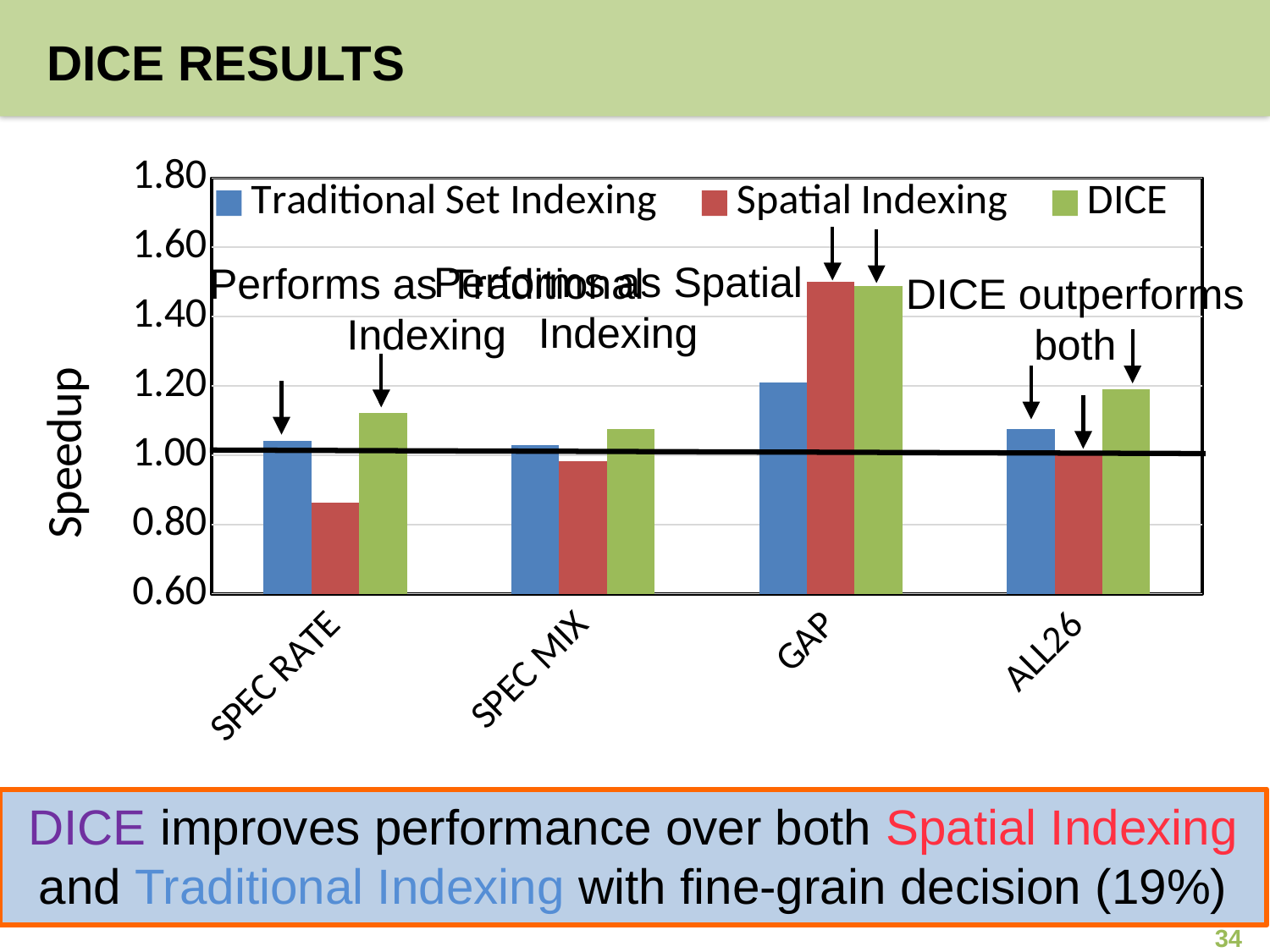
Is the Traditional Set Indexing value for GAP greater or less than 1.40? less Which category has the highest DICE speedup? GAP Which category has the lowest Spatial Indexing speedup? SPEC RATE Is the Spatial Indexing value for SPEC RATE greater or less than 1.00? less Is the DICE value for ALL26 greater or less than 1.00? greater How many series does the legend list? 3 For SPEC RATE, which is larger: the DICE value or the Spatial Indexing value? DICE What kind of chart is shown on the slide? bar chart How many categories are shown on the x axis? 4 For GAP, which is larger: the Traditional Set Indexing value or the Spatial Indexing value? Spatial Indexing What is the label of the y axis? Speedup